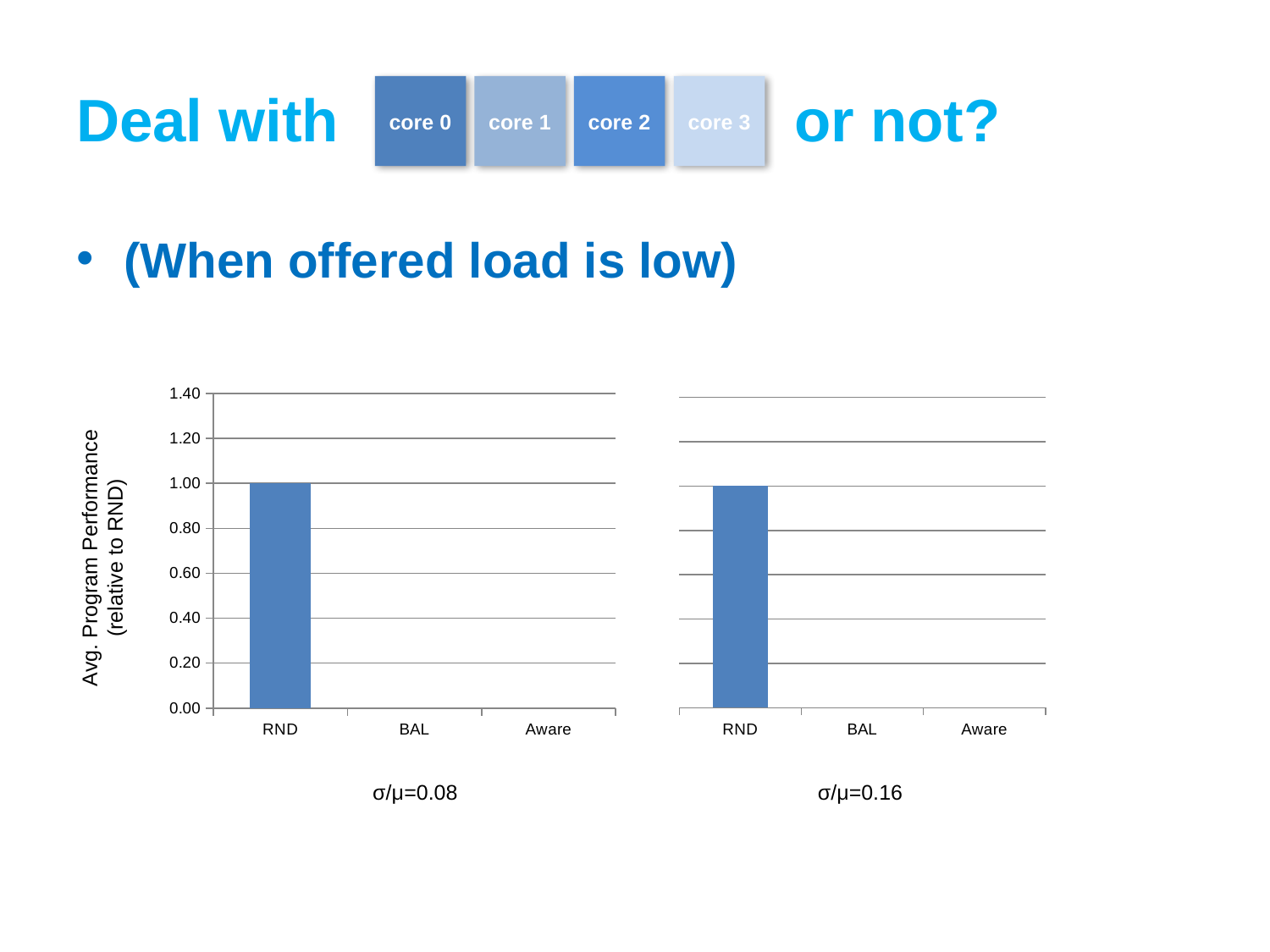
What is the label of the y axis shared by the two charts? Avg. Program Performance (relative to RND) In the σ/μ=0.16 chart, is the value for RND greater or less than 0.60? greater What kind of chart is the σ/μ=0.08 chart? bar chart In the σ/μ=0.08 chart, what is the value for RND? 1.00 How many bar charts are shown on the slide? 2 How many categories are shown on the x axis of the σ/μ=0.16 chart? 3 What is the highest tick value shown on the y axis of the σ/μ=0.08 chart? 1.40 In the σ/μ=0.16 chart, is the value for RND greater or less than 0.80? greater In the σ/μ=0.08 chart, is the value for RND greater or less than 1.20? less